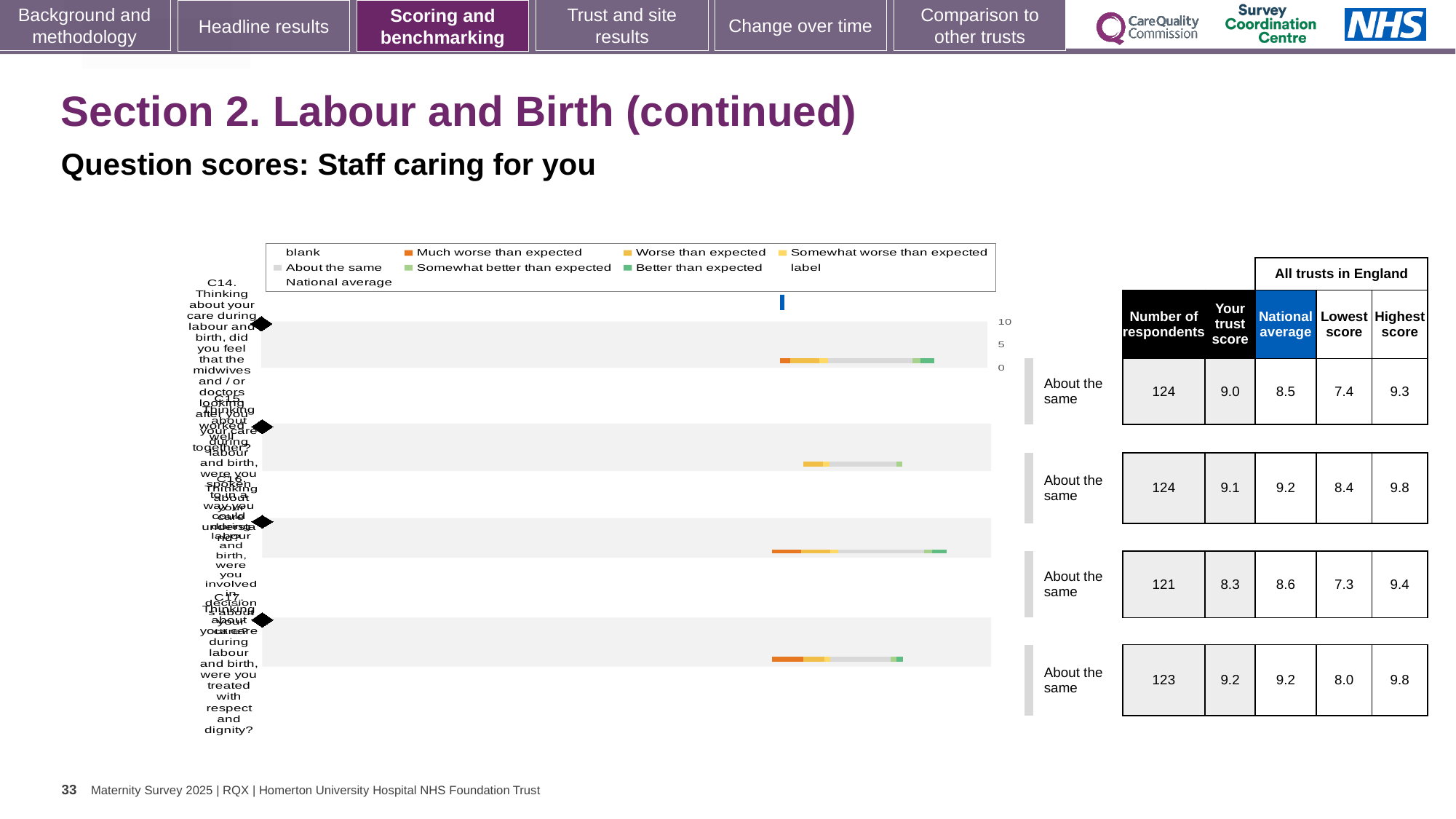
In the table next to the chart, what is the number of respondents for the first row (C14)? 124 In the table next to the chart, what is 'Your trust score' for the row with 121 respondents? 8.3 What kind of chart is shown on the slide? bar chart What is the lowest value in the 'Lowest score' column of the table next to the chart? 7.3 What is the highest tick value shown on the chart's numeric axis? 10 How many question bars are plotted in the chart? 4 Which row has the highest 'Your trust score' in the table next to the chart? the last row (C17), 9.2 For the first row (C14), which is larger: 'Your trust score' or the national average? Your trust score What benchmark category is shown for each of the four questions? About the same For the first row (C14), what is the difference between the highest score and the lowest score? 1.9 What colour does the legend use for 'Much worse than expected'? orange In the table next to the chart, what is the national average for the last row (C17)? 9.2